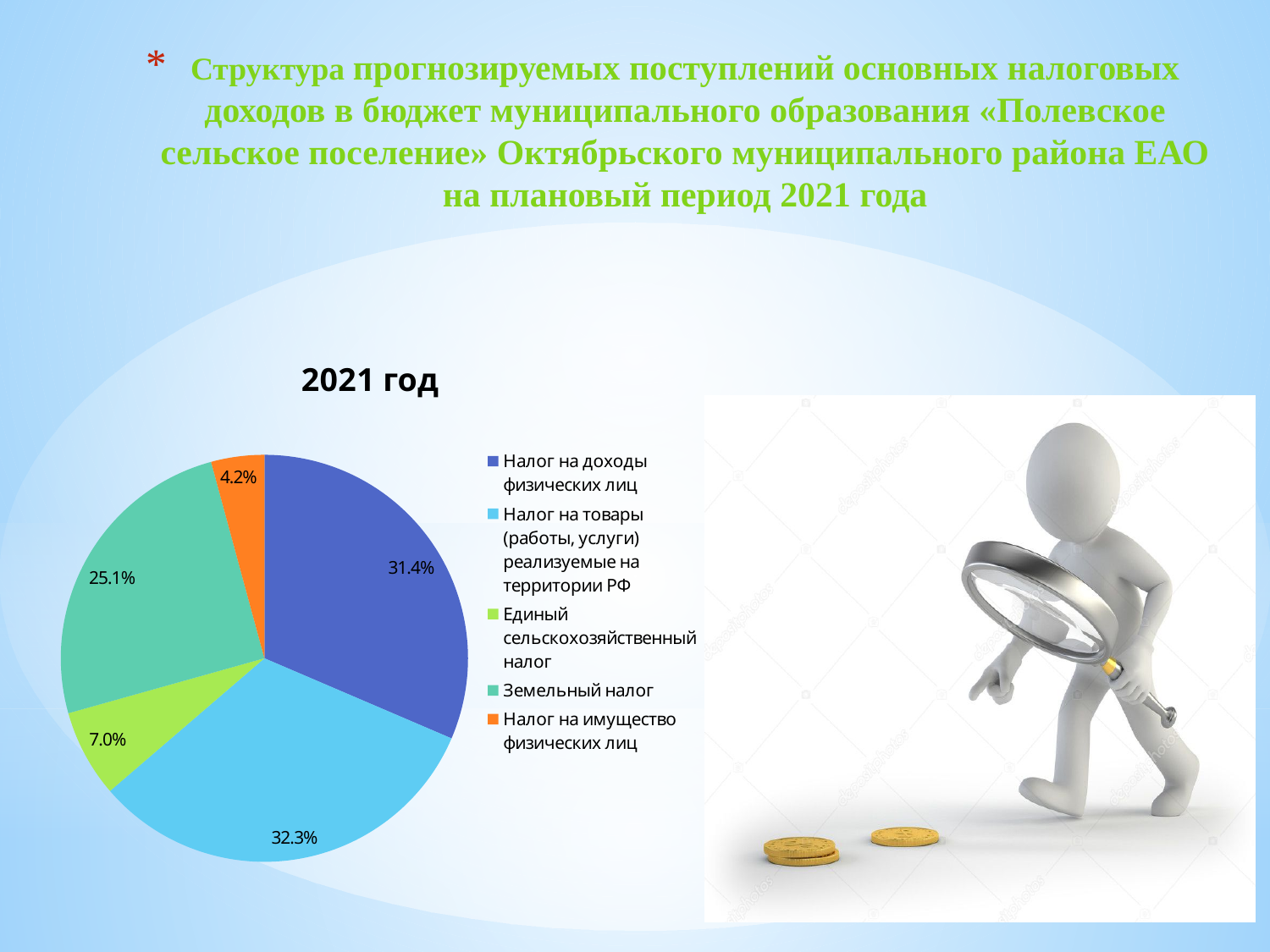
What share of the pie is Налог на имущество физических лиц? 4.2% What is the difference in percentage points between Земельный налог and Единый сельскохозяйственный налог? 18.1 Which is larger: the share for Налог на доходы физических лиц or the share for Земельный налог? Налог на доходы физических лиц Which category has the largest share of the pie? Налог на товары (работы, услуги) реализуемые на территории РФ What share of the pie is Налог на доходы физических лиц? 31.4% What kind of chart is shown on the slide? pie chart Which category has the smallest share of the pie? Налог на имущество физических лиц What is the title of the chart? 2021 год What share of the pie is Земельный налог? 25.1% How many entries does the legend list? 5 How many slices does the pie chart have? 5